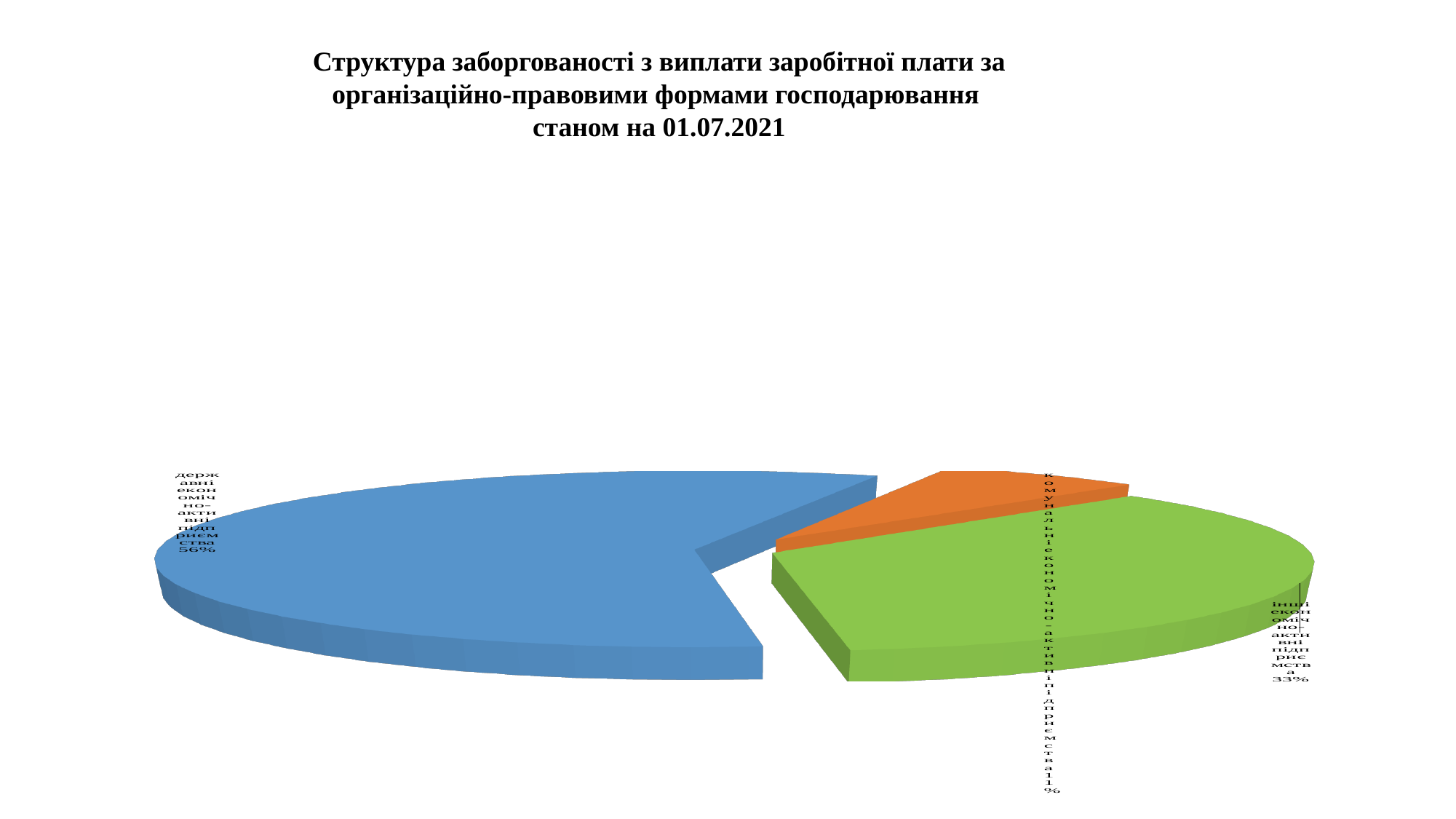
Which category has the smallest slice of the pie? комунальні економічно-активні підприємства Which category has the largest slice of the pie? державні економічно-активні підприємства What is the difference in percentage points between the державні slice and the інші slice? 23 As of what date does the chart title say the data is given? 01.07.2021 How many slices does the pie chart have? 3 What colour is the slice for державні економічно-активні підприємства? blue What share of the pie is labelled for комунальні економічно-активні підприємства? 11% What share of the pie is labelled for інші економічно-активні підприємства? 33% Which is larger: the share for інші економічно-активні підприємства or the share for комунальні економічно-активні підприємства? інші економічно-активні підприємства What share of the pie is labelled for державні економічно-активні підприємства? 56% What kind of chart is shown on the slide? pie chart What is the combined share of the комунальні and інші slices? 44%